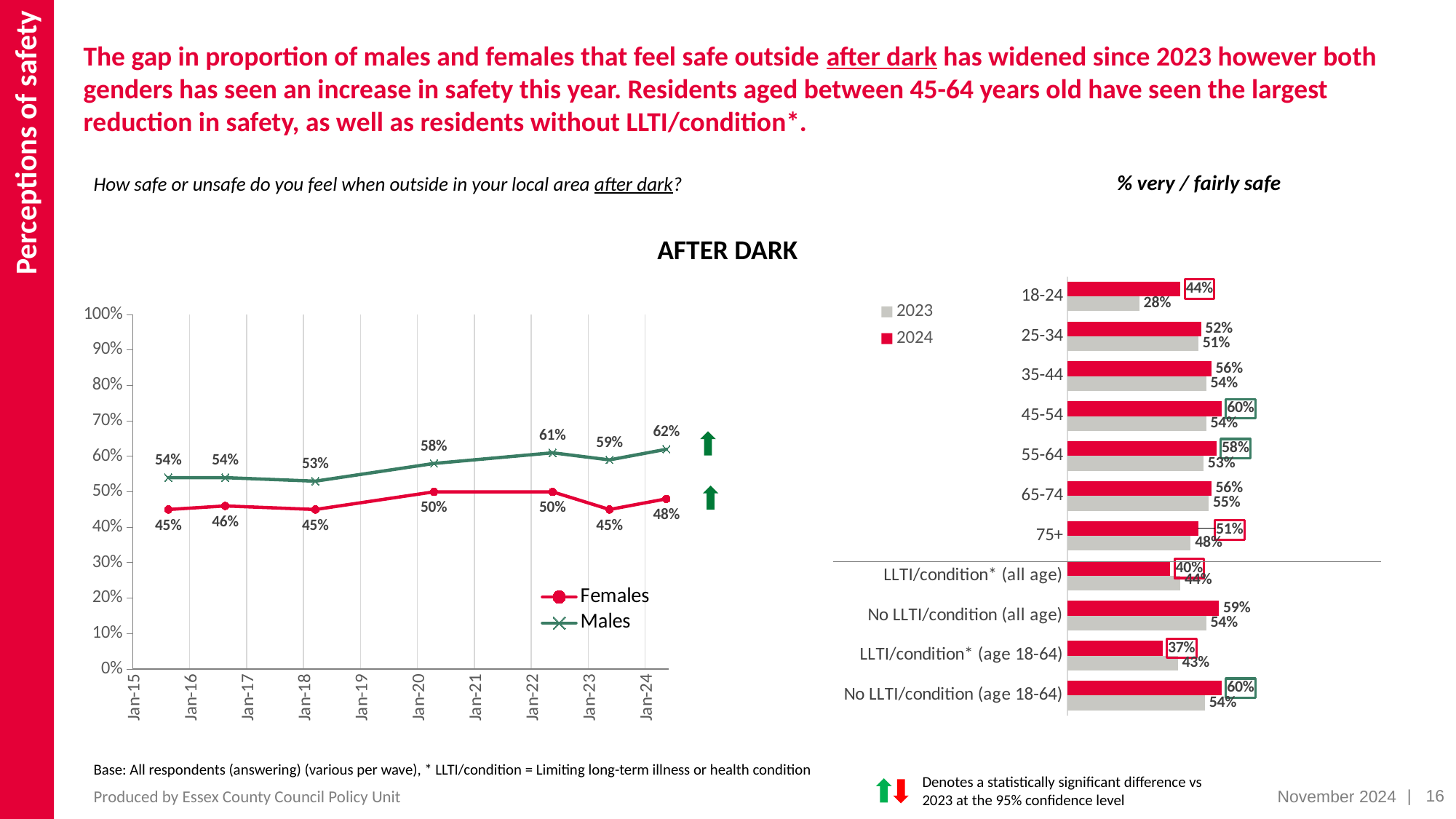
In the AFTER DARK line chart, how many series does the legend list? 2 In the AFTER DARK line chart, what is the value for Females at the most recent data point? 48% In the AFTER DARK line chart, what is the highest value shown for Males? 62% In the AFTER DARK line chart, what is the lowest value shown for Females? 45% In the AFTER DARK line chart, what is the difference between Males and Females at the most recent data point? 14 percentage points What type of chart is the chart on the right of the slide showing age groups and LLTI/condition? Bar chart In the bar chart on the right, which is larger for LLTI/condition* (all age): the 2023 value or the 2024 value? 2023 In the bar chart on the right, what is the difference between the 2024 and 2023 values for 45-54? 6 percentage points In the bar chart on the right, what is the 2023 value for the 18-24 age group? 28% In the bar chart on the right, which age group has the lowest 2024 value? 18-24 In the AFTER DARK line chart, what is the value for Males at the most recent data point? 62% In the bar chart on the right, what is the 2024 value for the 18-24 age group? 44%